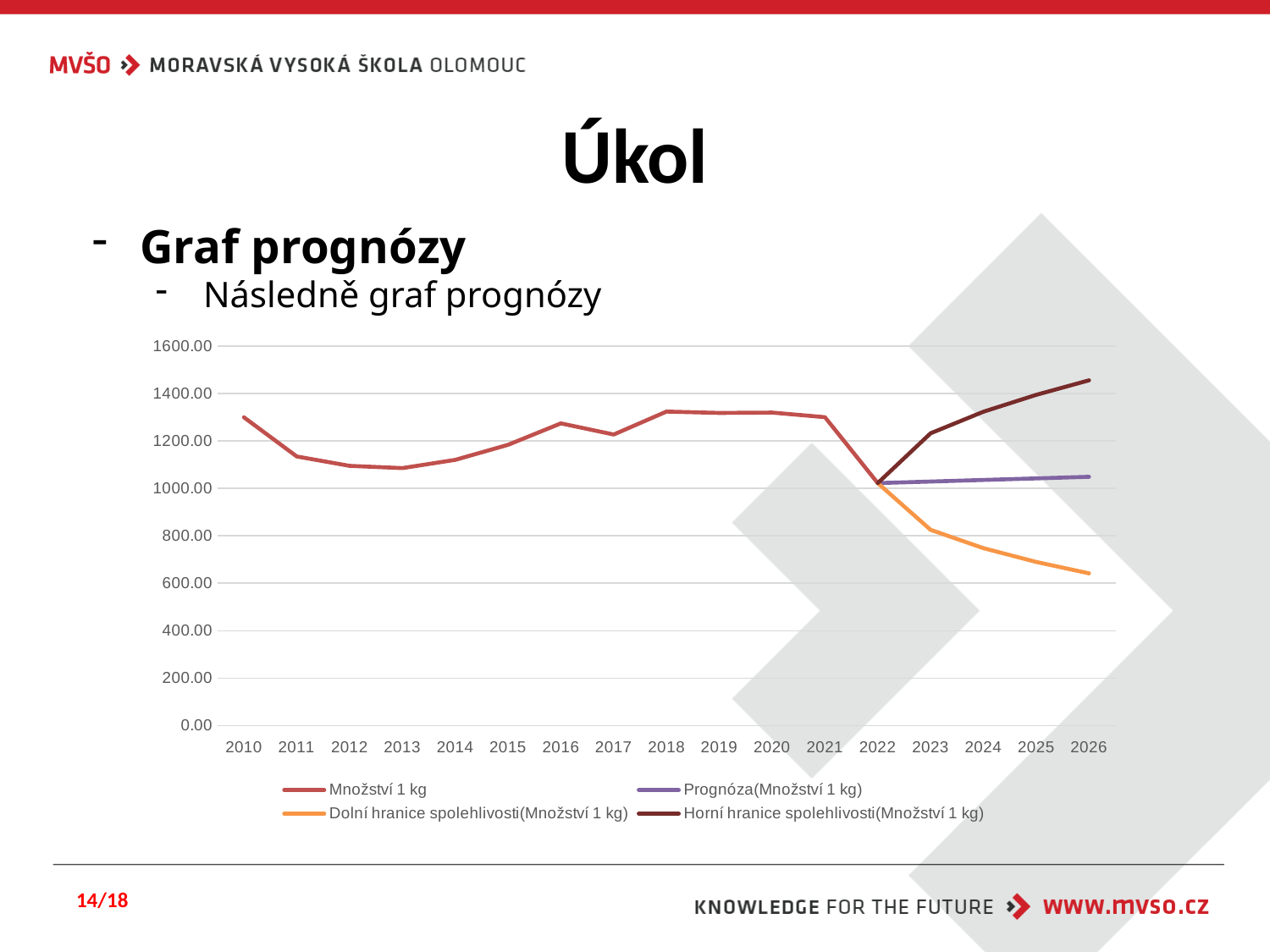
In 2026, which is larger: Horní hranice spolehlivosti(Množství 1 kg) or Dolní hranice spolehlivosti(Množství 1 kg)? Horní hranice spolehlivosti(Množství 1 kg) How many series does the chart legend list? 4 What kind of chart is shown on the slide? line chart Does the Horní hranice spolehlivosti(Množství 1 kg) series rise or fall from 2022 to 2026? rise Is the value of Množství 1 kg in 2013 greater or less than 1200? less Which series is drawn in orange in the chart? Dolní hranice spolehlivosti(Množství 1 kg) In which year is the Množství 1 kg series at its lowest? 2022 How many years are shown on the x axis of the chart? 17 Is the value of Dolní hranice spolehlivosti(Množství 1 kg) in 2026 greater or less than 800? less Is the value of Horní hranice spolehlivosti(Množství 1 kg) in 2026 greater or less than 1200? greater Does the Dolní hranice spolehlivosti(Množství 1 kg) series rise or fall from 2022 to 2026? fall